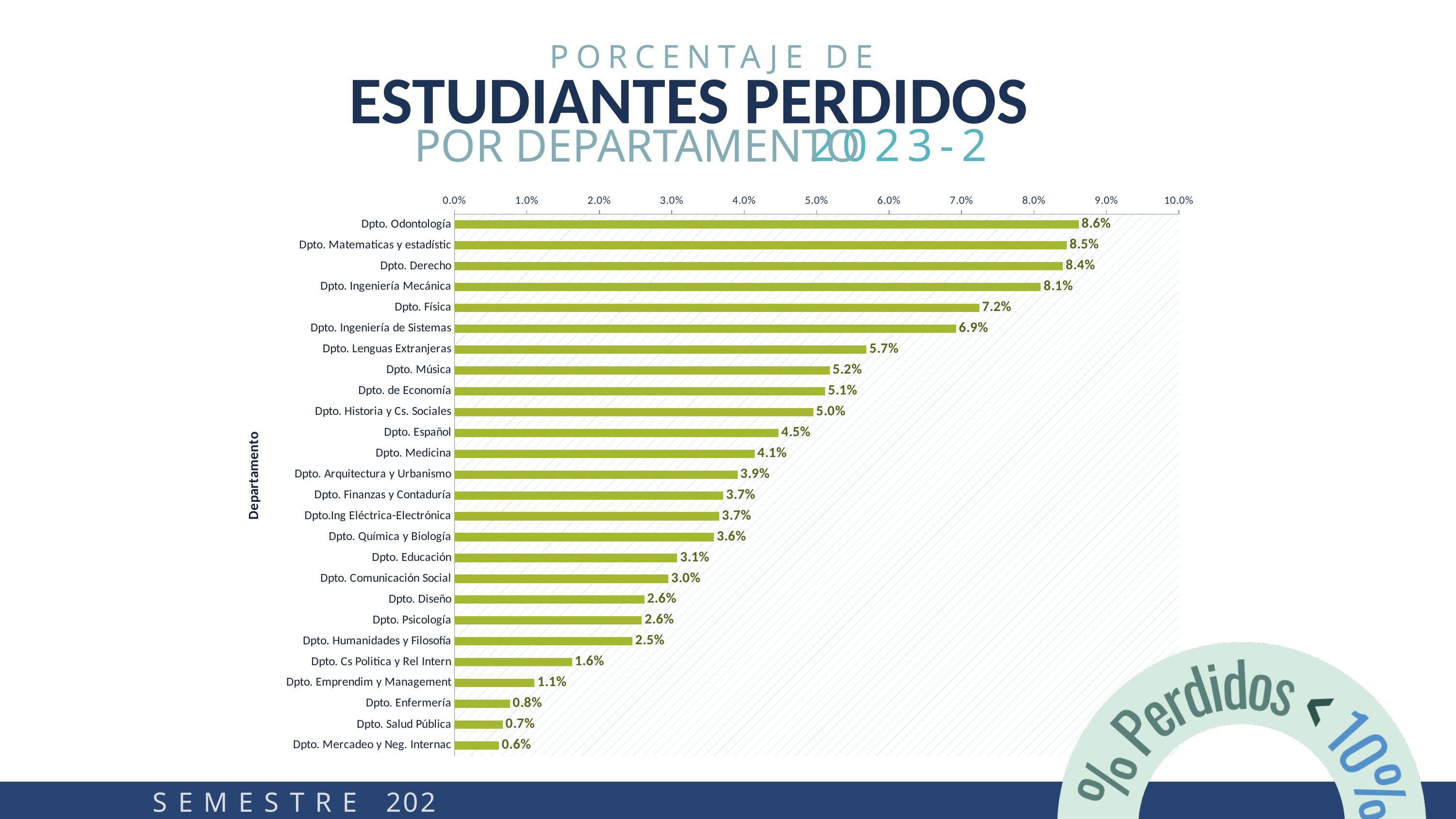
How many departments are shown in the chart? 26 Is the value for Dpto. Ingeniería Mecánica greater or less than 7.0%? greater Which is larger, the value for Dpto. Lenguas Extranjeras or the value for Dpto. Español? Dpto. Lenguas Extranjeras Which department has the highest percentage of lost students? Dpto. Odontología What is the value for Dpto. Medicina? 4.1% What is the value for Dpto. Odontología? 8.6% What is the value for Dpto. Física? 7.2% What is the value for Dpto. Enfermería? 0.8% What is the difference between the values for Dpto. Derecho and Dpto. Ingeniería de Sistemas? 1.5% Which department has the lowest percentage of lost students? Dpto. Mercadeo y Neg. Internac What is the label of the vertical axis of the chart? Departamento What kind of chart is shown on the slide? bar chart